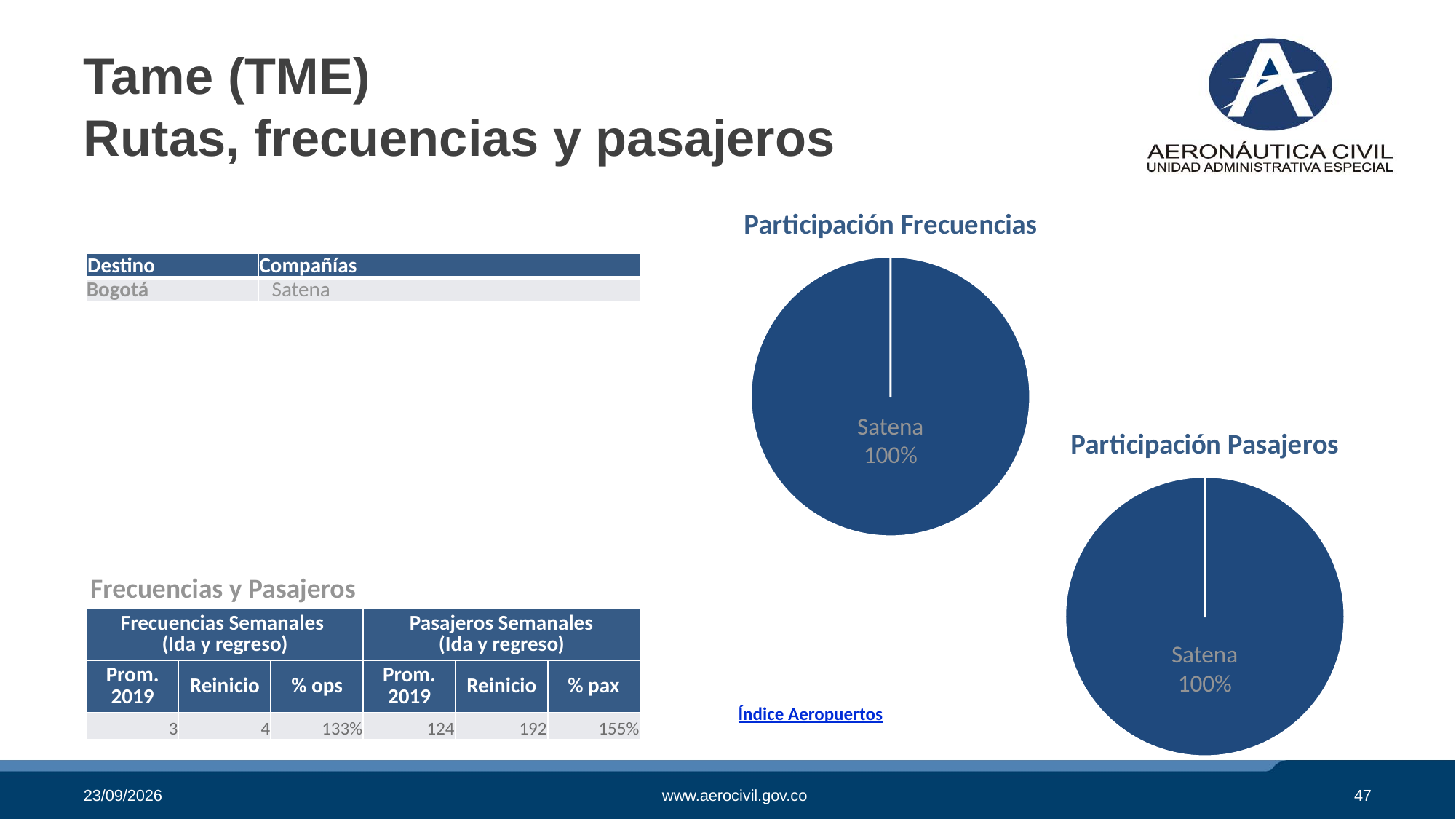
Which company is shown in the 'Participación Frecuencias' chart? Satena What kind of chart is 'Participación Pasajeros'? Pie chart What is the title of the pie chart positioned at the top right of the slide? Participación Frecuencias Which company is shown in the 'Participación Pasajeros' chart? Satena In the 'Participación Pasajeros' chart, what share does Satena have? 100% In the 'Participación Frecuencias' chart, what share does Satena have? 100% What kind of chart is 'Participación Frecuencias'? Pie chart How many pie charts are on the slide? 2 How many slices does the 'Participación Frecuencias' pie chart have? 1 How many slices does the 'Participación Pasajeros' pie chart have? 1 What is the title of the pie chart positioned at the bottom right of the slide? Participación Pasajeros